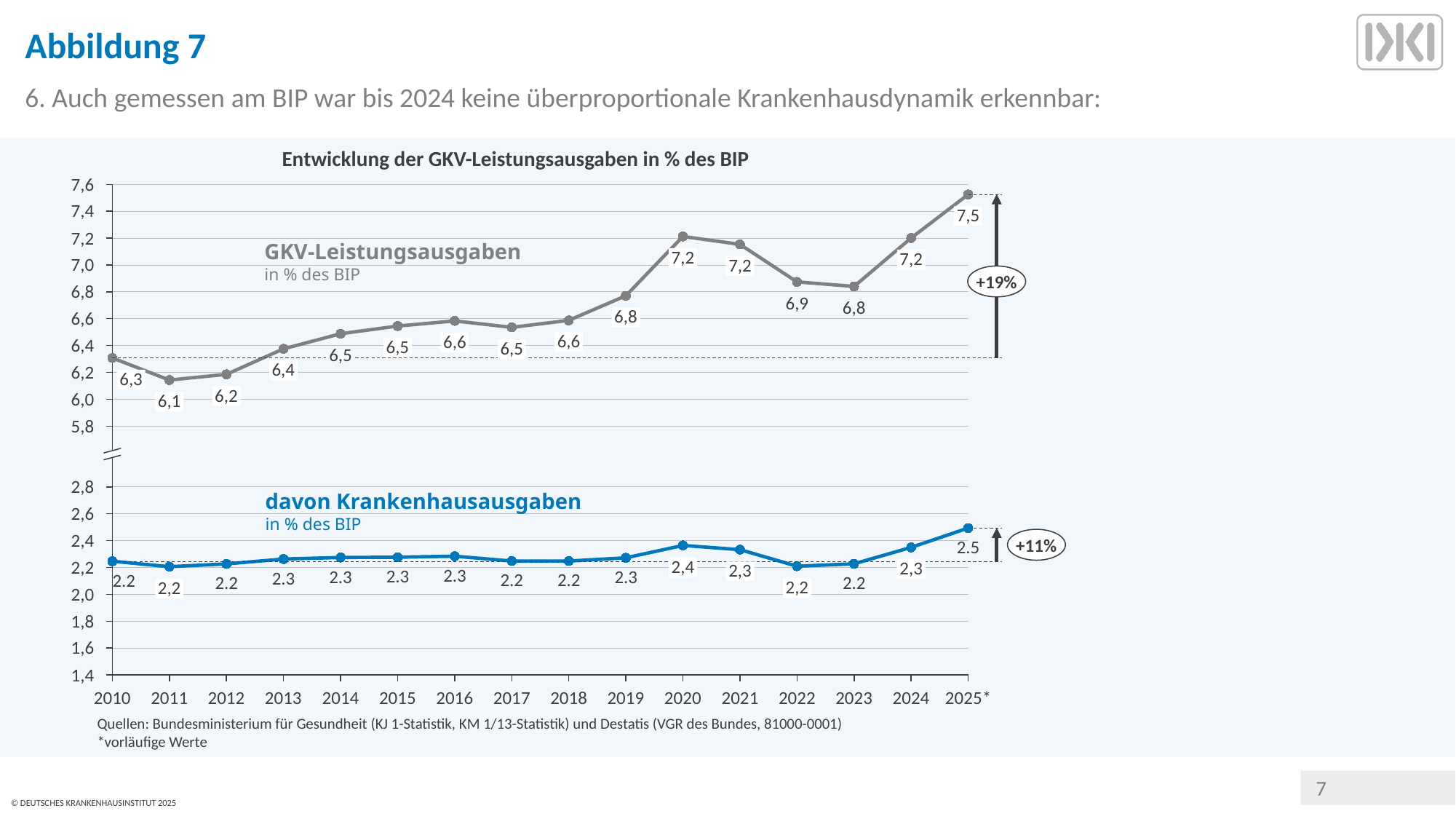
What percentage change is shown in the annotation next to the GKV-Leistungsausgaben line? +19% What type of chart is shown on the slide? line chart What is the difference between the GKV-Leistungsausgaben value for 2025* and for 2010? 1,2 In which year is GKV-Leistungsausgaben in % des BIP at its lowest? 2011 Does GKV-Leistungsausgaben in % des BIP rise or fall from 2023 to 2025*? rise How many years are shown on the x axis of the chart? 16 What is the value of GKV-Leistungsausgaben in % des BIP for 2020? 7,2 What is the value of davon Krankenhausausgaben in % des BIP for 2025*? 2,5 How many series are plotted in the chart? 2 What is the title of the chart? Entwicklung der GKV-Leistungsausgaben in % des BIP In which year is GKV-Leistungsausgaben in % des BIP at its highest? 2025*